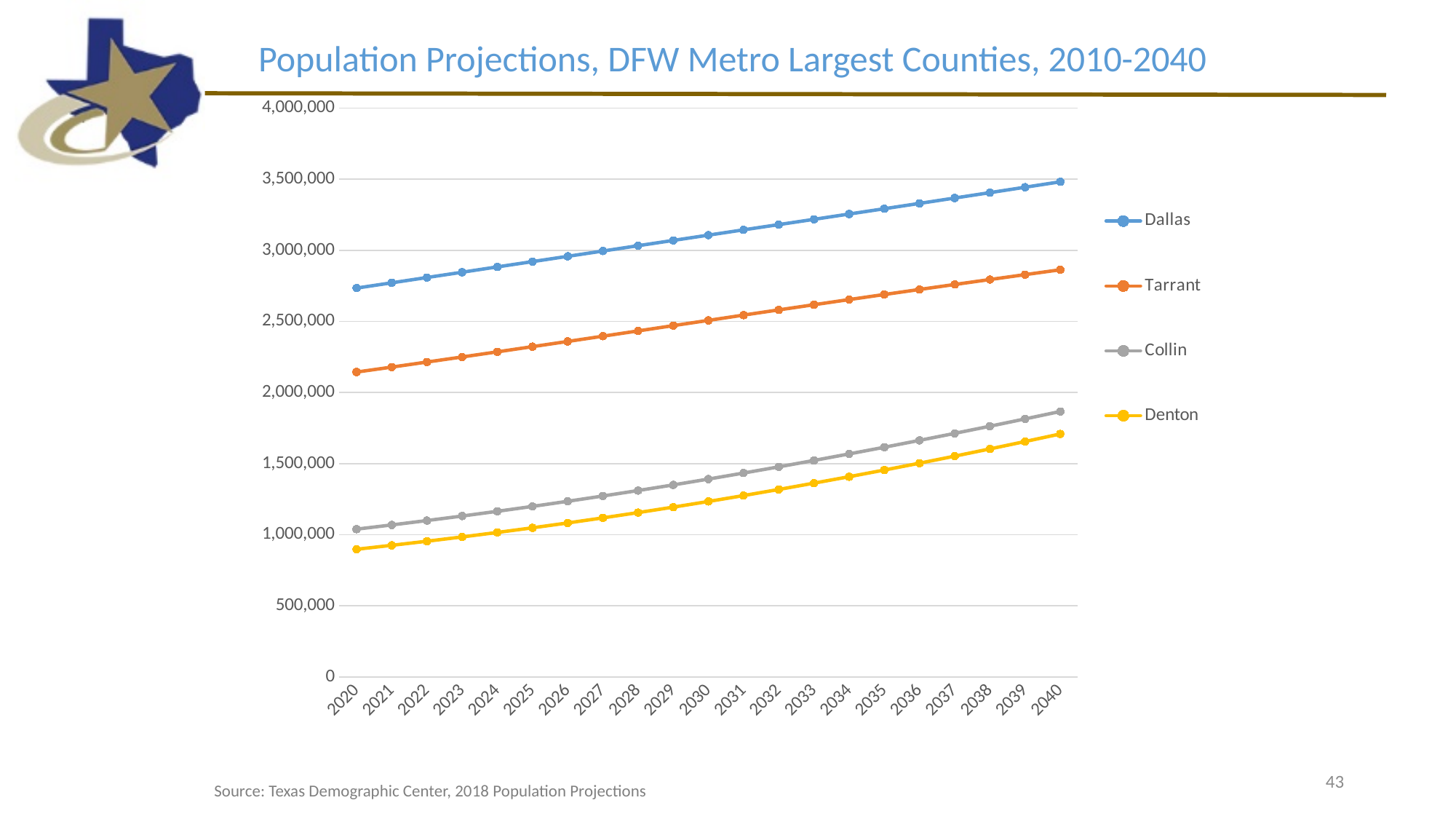
How many series does the legend list? 4 Do the projected populations rise or fall from 2020 to 2040? rise Is the value for Dallas in 2020 greater or less than 2,500,000? greater Which county has the lowest projected population in 2020? Denton Which county has the highest projected population in 2040? Dallas How many years are plotted along the x axis? 21 Is the value for Collin in 2040 greater or less than 2,000,000? less What colour is the line for Denton in the legend? yellow In 2030, which is larger, the value for Collin or the value for Denton? Collin Is the value for Denton in 2020 greater or less than 1,000,000? less What kind of chart is shown on the slide? line chart